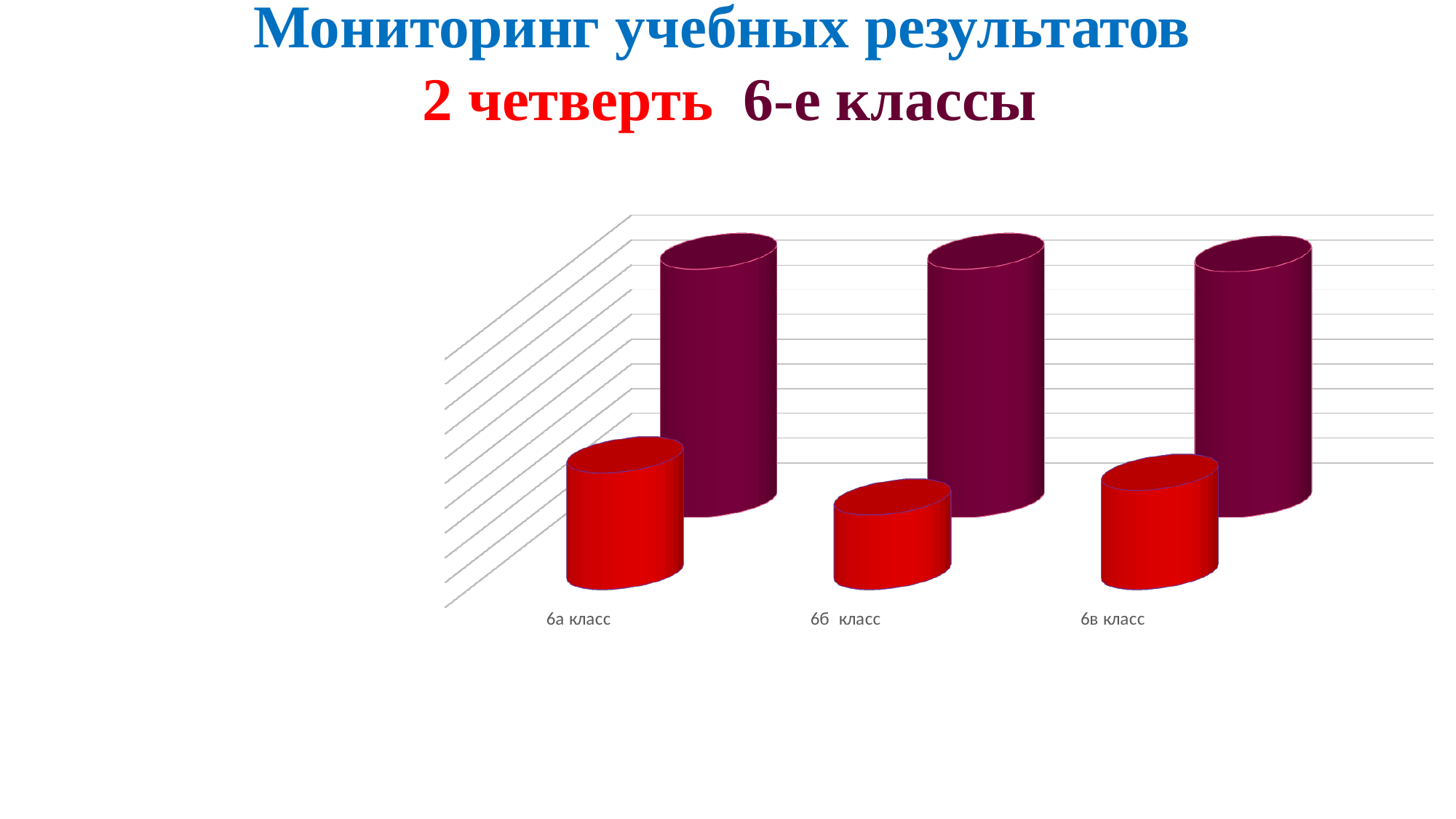
Is the red bar for 6а класс taller or shorter than the red bar for 6б класс? taller Which class has the lowest red bar in the chart? 6б класс What kind of chart is shown on the slide? bar chart What is the label of the last category on the x axis of the chart? 6в класс How many categories (classes) are shown on the x axis of the chart? 3 Is the red bar for 6в класс taller or shorter than the red bar for 6б класс? taller How many bars are shown for each class in the chart? 2 In each category, is the dark purple bar taller or shorter than the red bar? taller What is the label of the first category on the x axis of the chart? 6а класс Which class has the highest red bar in the chart? 6а класс